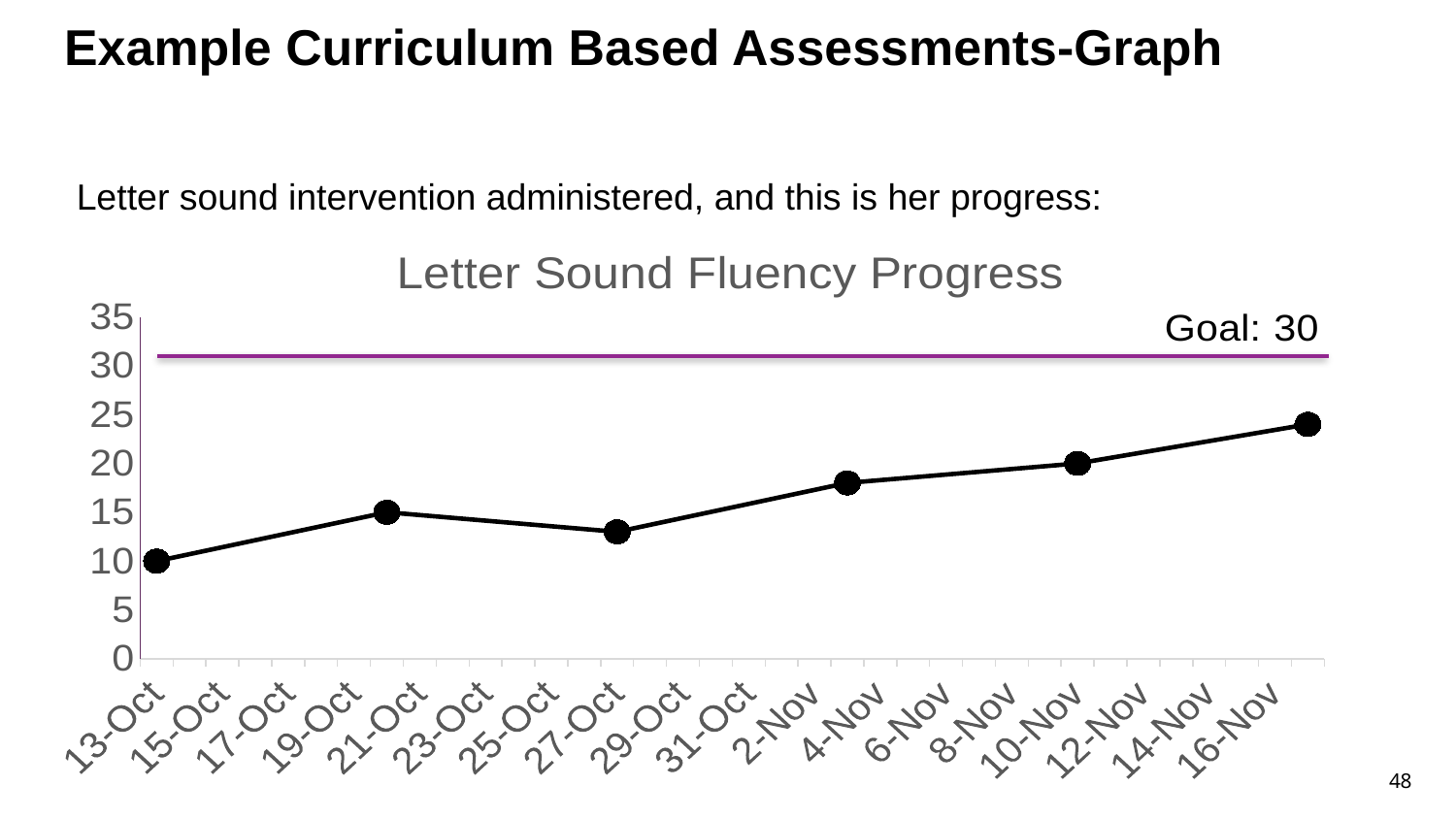
What type of chart is shown on the slide? line chart What goal value is marked by the horizontal line on the chart? 30 What is the title of the chart? Letter Sound Fluency Progress Do the plotted values generally rise or fall from left to right? rise Is the value on 27-Oct greater or less than 15? less On which date is the lowest value plotted? 13-Oct How many data points are plotted on the progress line? 6 What is the letter sound fluency value on 10-Nov? 20 What is the difference between the value on 10-Nov and the value on 13-Oct? 10 Which is larger, the value on 13-Oct or the value on 10-Nov? 10-Nov What is the letter sound fluency value on 13-Oct? 10